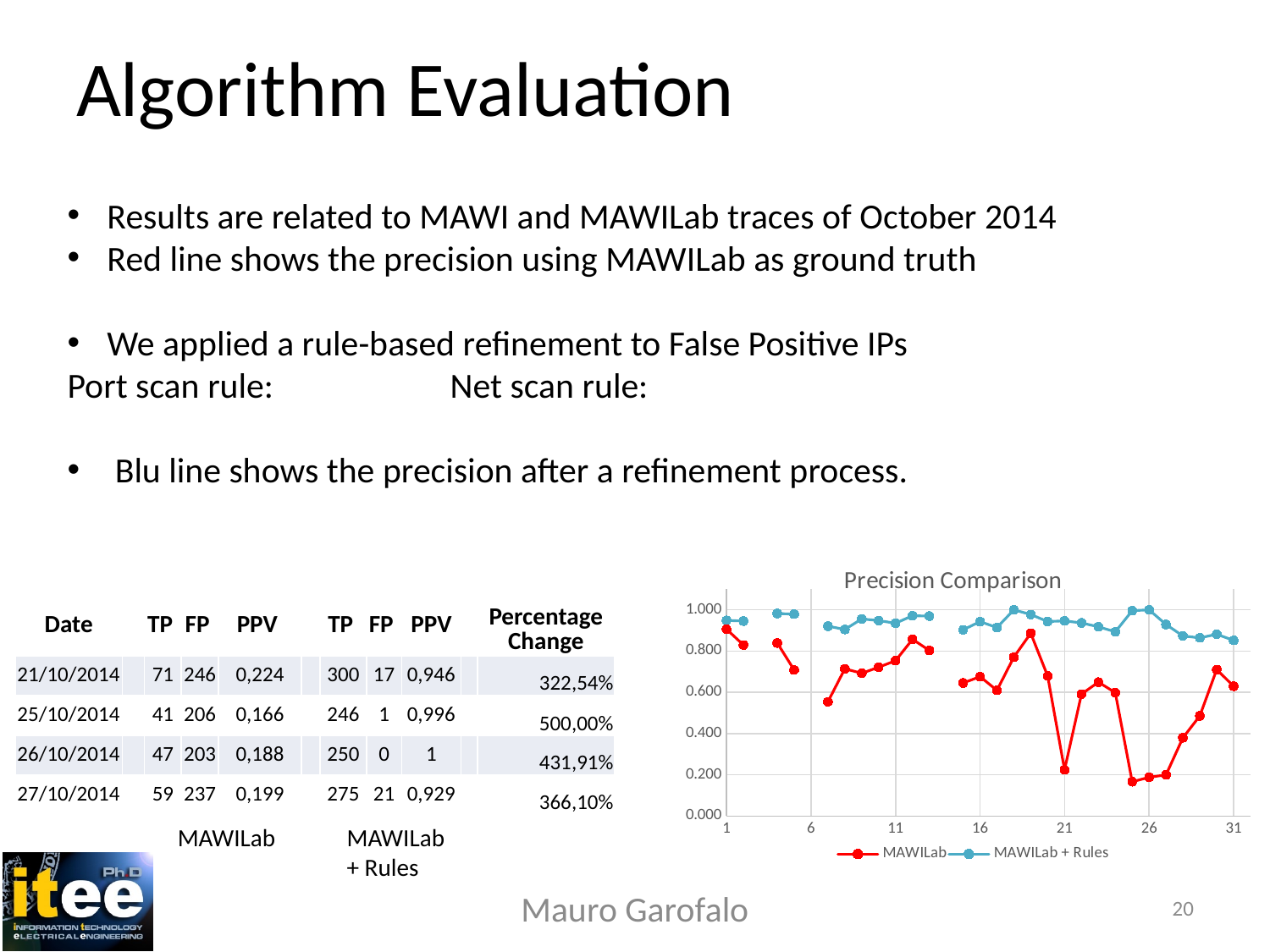
In the Precision Comparison chart, is the MAWILab value at day 21 greater or less than 0.400? less What is the title of the chart on the slide? Precision Comparison In the Precision Comparison chart, which series has the higher value at day 21, MAWILab or MAWILab + Rules? MAWILab + Rules What kind of chart is the Precision Comparison chart? line chart In the Precision Comparison chart, is the MAWILab value at day 25 greater or less than 0.400? less What is the highest value shown on the y axis of the Precision Comparison chart? 1.000 How many series does the legend of the Precision Comparison chart list? 2 In the Precision Comparison chart, is the MAWILab value at day 1 greater or less than 0.800? greater In the Precision Comparison chart, which series stays higher across the whole month, MAWILab or MAWILab + Rules? MAWILab + Rules Which series in the Precision Comparison chart is drawn in red? MAWILab In the Precision Comparison chart, does the MAWILab line rise or fall between day 19 and day 21? fall